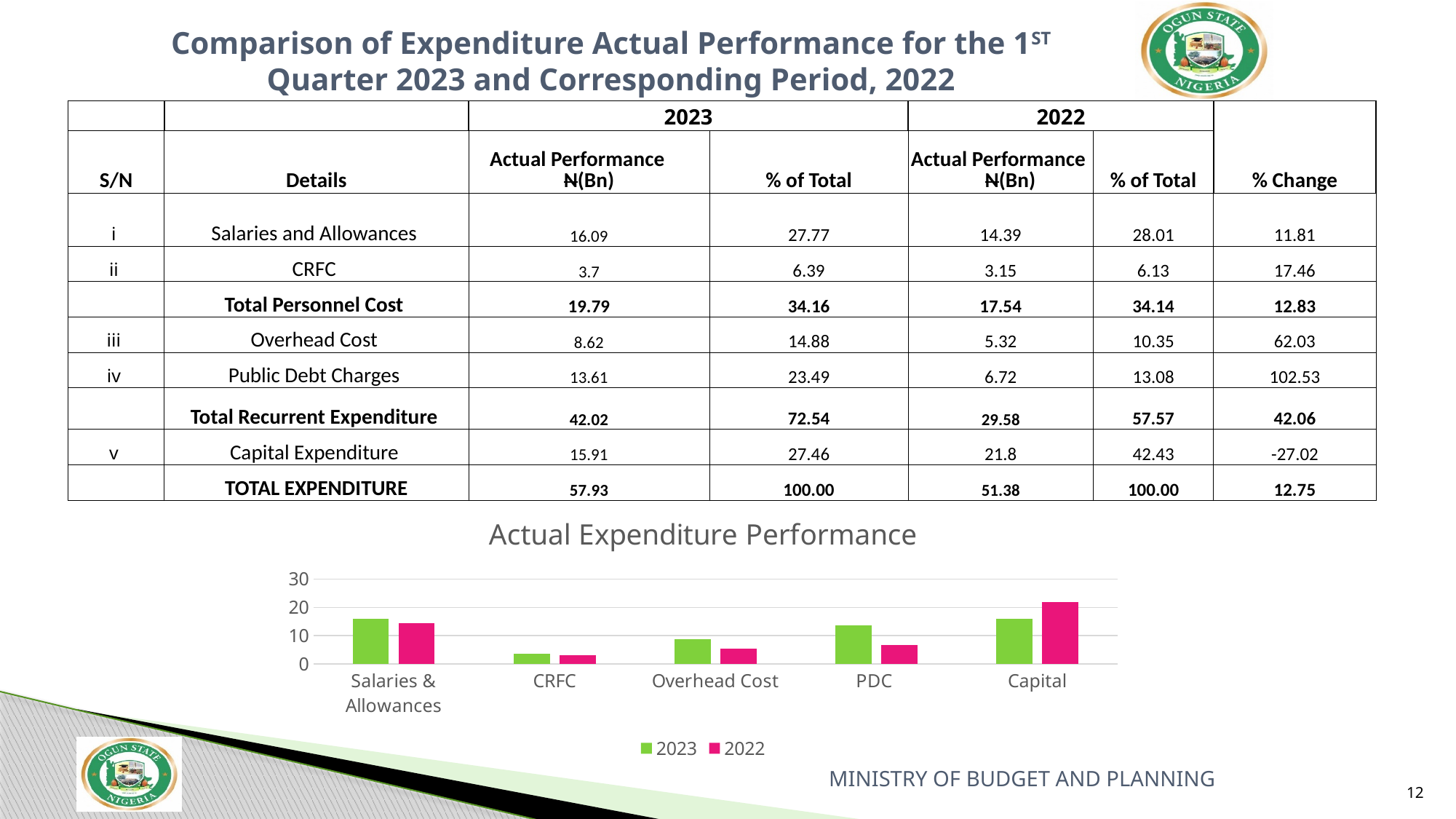
In the "Actual Expenditure Performance" chart, is the 2022 value for Capital greater or less than 20? greater In the "Actual Expenditure Performance" chart, which category has the lowest 2023 value? CRFC In the "Actual Expenditure Performance" chart, which category has the tallest bar overall? Capital In the "Actual Expenditure Performance" chart, which is larger for Overhead Cost: the 2023 value or the 2022 value? 2023 In the "Actual Expenditure Performance" chart, which category has the lowest 2022 value? CRFC In the "Actual Expenditure Performance" chart, what colour represents the 2022 series? Pink How many series does the legend of the "Actual Expenditure Performance" chart list? 2 In the "Actual Expenditure Performance" chart, which is larger for Capital: the 2023 value or the 2022 value? 2022 How many categories are shown on the x axis of the "Actual Expenditure Performance" chart? 5 In the "Actual Expenditure Performance" chart, is the 2022 value for PDC greater or less than 10? less What type of chart is shown under the title "Actual Expenditure Performance"? Bar chart In the "Actual Expenditure Performance" chart, is the 2023 value for Salaries & Allowances greater or less than 10? greater